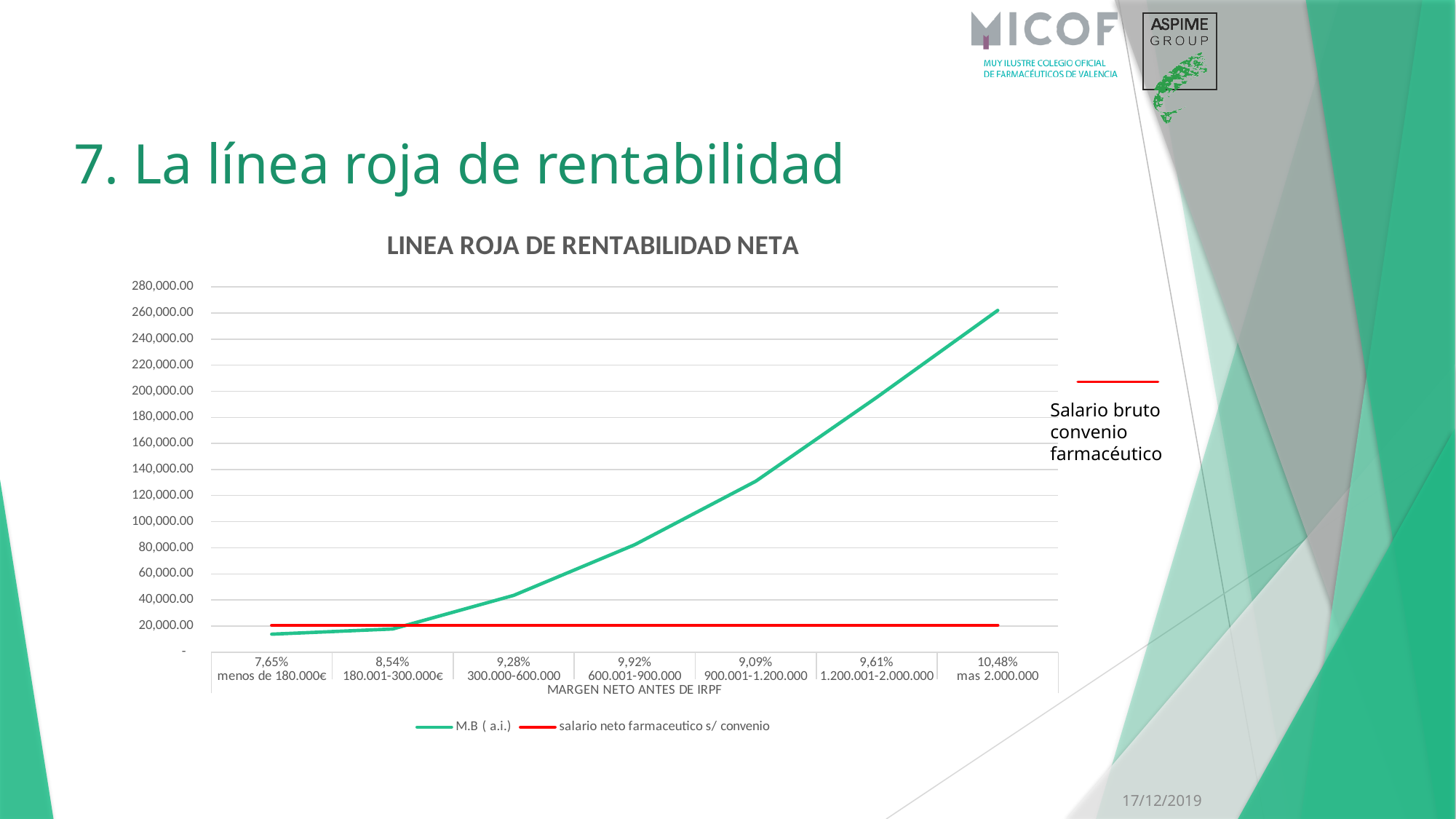
Which category has the highest value for the M.B ( a.i.) series? 10,48% mas 2.000.000 What is the title of the chart? LINEA ROJA DE RENTABILIDAD NETA Is the M.B ( a.i.) value for the category 900.001-1.200.000 greater or less than 120,000.00? greater Is the M.B ( a.i.) value for the category menos de 180.000€ greater or less than 20,000.00? less At the category menos de 180.000€, which series has the larger value: M.B ( a.i.) or salario neto farmaceutico s/ convenio? salario neto farmaceutico s/ convenio Does the M.B ( a.i.) series rise or fall along the x axis? rise What kind of chart is shown on the slide? line chart Is the M.B ( a.i.) value for the category mas 2.000.000 greater or less than 240,000.00? greater How many categories are shown on the x axis? 7 What is the label of the x axis? MARGEN NETO ANTES DE IRPF Which category has the lowest value for the M.B ( a.i.) series? 7,65% menos de 180.000€ How many series does the legend list? 2